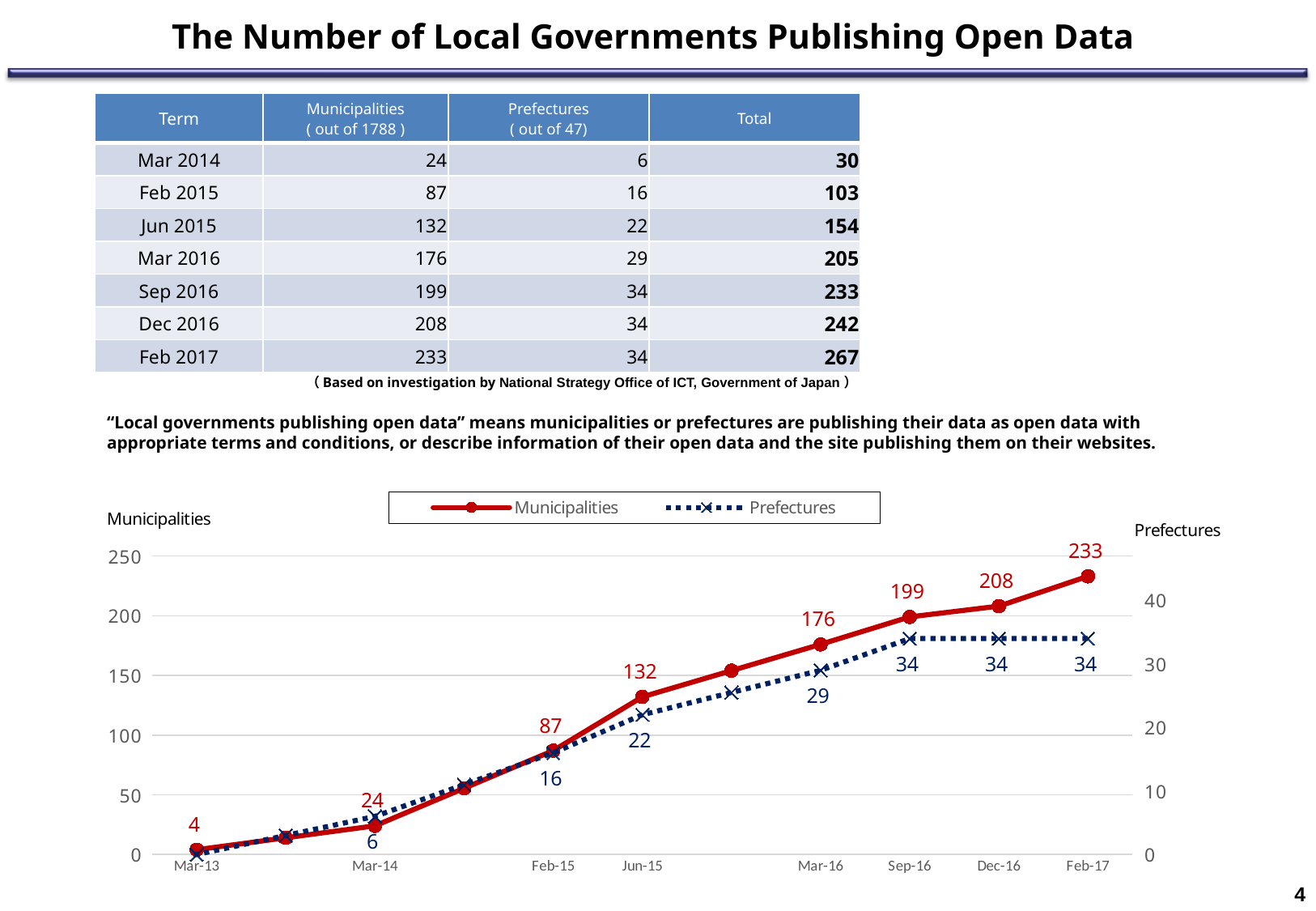
Which is larger for Municipalities: the value at Sep-16 or the value at Mar-16? Sep-16 What is the value for Prefectures at Mar-16? 29 What is the difference between the Municipalities values at Feb-17 and Dec-16? 25 At which date does the Municipalities series reach its highest value? Feb-17 What is the value for Prefectures at Feb-15? 16 What kind of chart is shown on the slide? line chart What is the value for Municipalities at Jun-15? 132 At which date is the Municipalities series at its lowest value? Mar-13 How many series does the legend list? 2 Do the Municipalities values rise or fall from Mar-13 to Feb-17? rise Is the Municipalities value at Mar-16 greater or less than 150? greater What is the value for Municipalities at Feb-17? 233